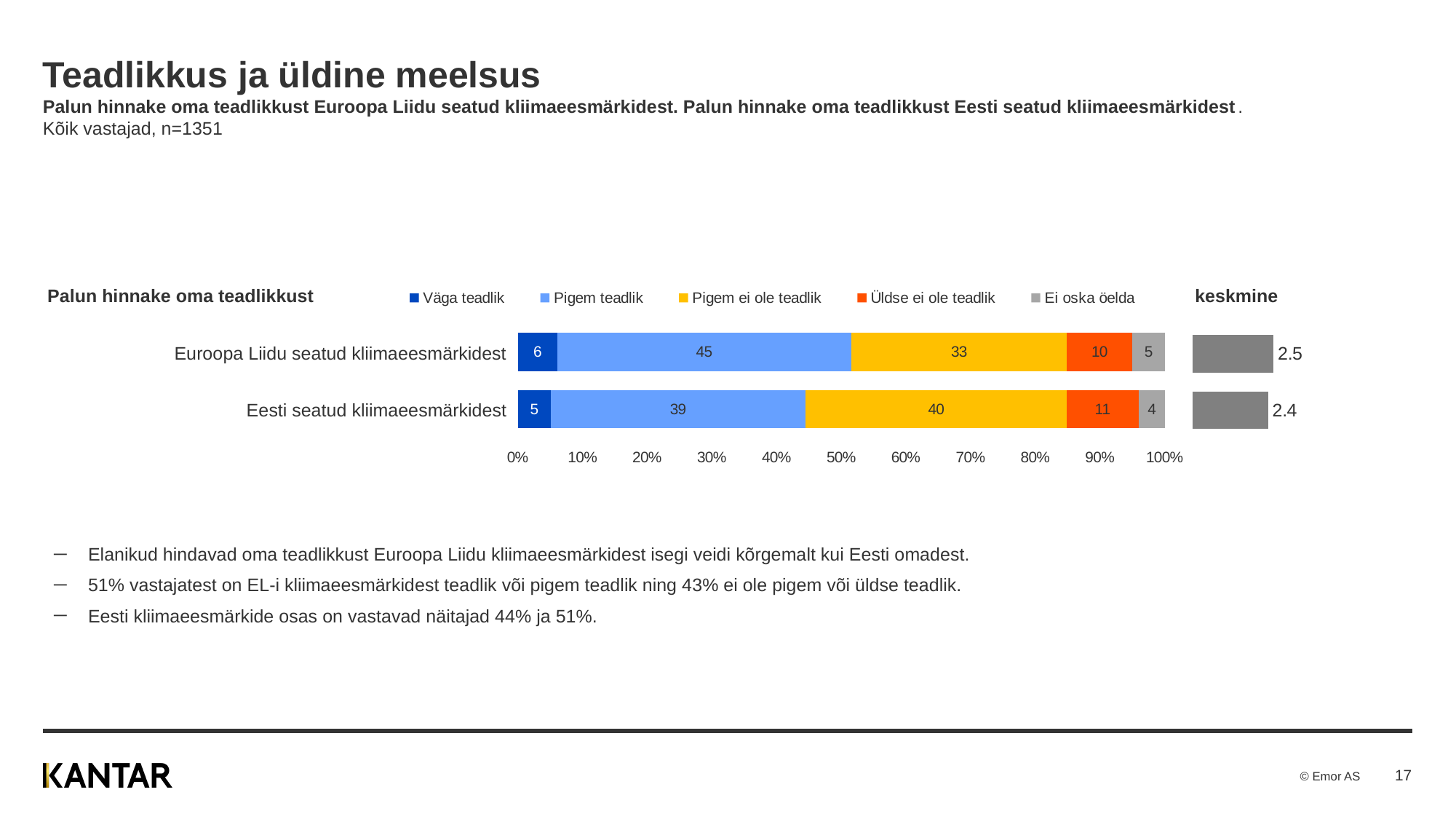
What is the 'keskmine' (average) value for 'Euroopa Liidu seatud kliimaeesmärkidest'? 2.5 What kind of chart is used to show the awareness ratings on the slide? stacked bar chart What is the 'Väga teadlik' value for 'Eesti seatud kliimaeesmärkidest'? 5 Which segment is the largest in the 'Eesti seatud kliimaeesmärkidest' bar? Pigem ei ole teadlik How many categories (rows) are shown in the awareness chart? 2 How many series does the legend of the awareness chart list? 5 What is the difference between the 'Pigem teadlik' values for 'Euroopa Liidu seatud kliimaeesmärkidest' and 'Eesti seatud kliimaeesmärkidest'? 6 What colour represents 'Pigem ei ole teadlik' in the awareness chart? yellow What is the 'Pigem ei ole teadlik' value for 'Eesti seatud kliimaeesmärkidest'? 40 Which category has the higher 'keskmine' value, 'Euroopa Liidu seatud kliimaeesmärkidest' or 'Eesti seatud kliimaeesmärkidest'? Euroopa Liidu seatud kliimaeesmärkidest What is the 'Üldse ei ole teadlik' value for 'Euroopa Liidu seatud kliimaeesmärkidest'? 10 What is the 'Pigem teadlik' value for 'Euroopa Liidu seatud kliimaeesmärkidest'? 45